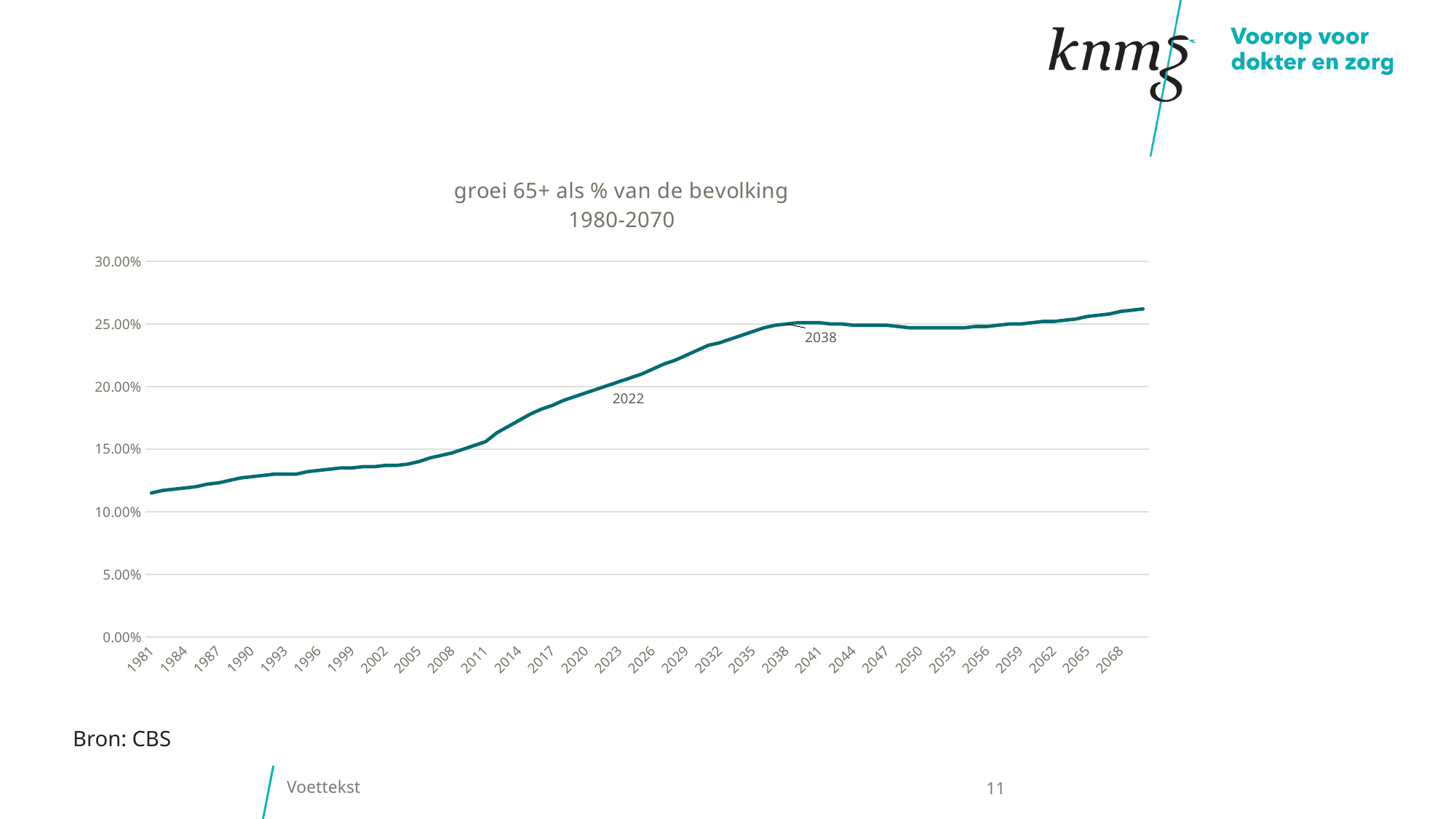
Does the line rise or fall between 1981 and 2038? rise What kind of chart is shown on the slide? line chart Is the value for 2050 greater or less than 30.00%? less Which is larger, the value for 1981 or the value for 2068? 2068 Is the value for 2068 greater or less than 25.00%? greater Is the value for 2011 greater or less than 20.00%? less What is the title of the chart? groei 65+ als % van de bevolking 1980-2070 Which year has the lowest value on the chart? 1981 What source is cited below the chart? Bron: CBS